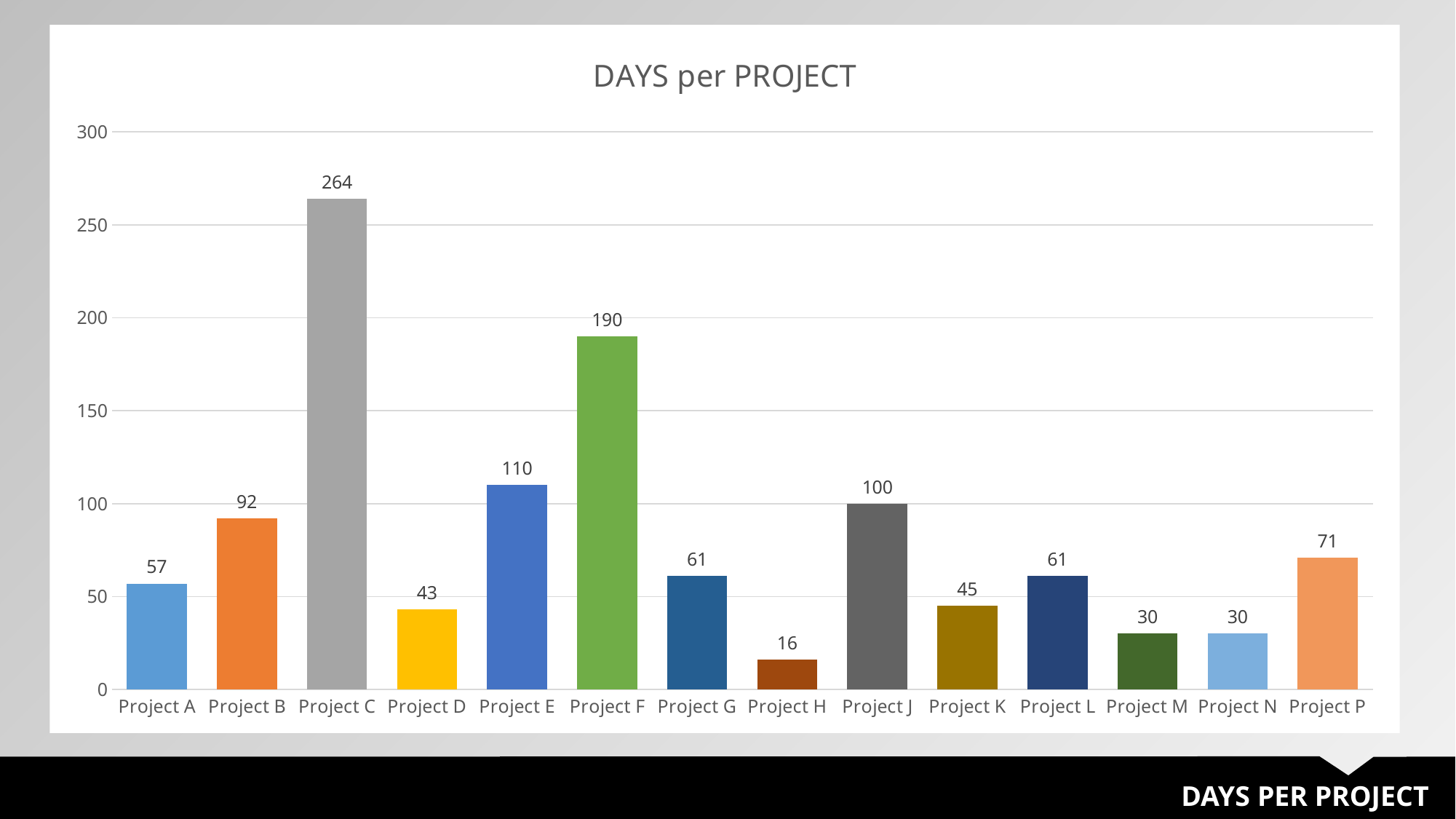
Which project has the lowest number of days? Project H How many projects are shown on the chart? 14 What is the title of the chart? DAYS per PROJECT Is the value for Project F greater or less than 150? greater What is the value for Project C? 264 Which project has the highest number of days? Project C What is the value for Project H? 16 Which is larger, the value for Project B or the value for Project K? Project B What is the difference between the values for Project E and Project J? 10 What kind of chart is shown on the slide? Bar chart What is the difference between the values for Project C and Project F? 74 What is the value for Project P? 71